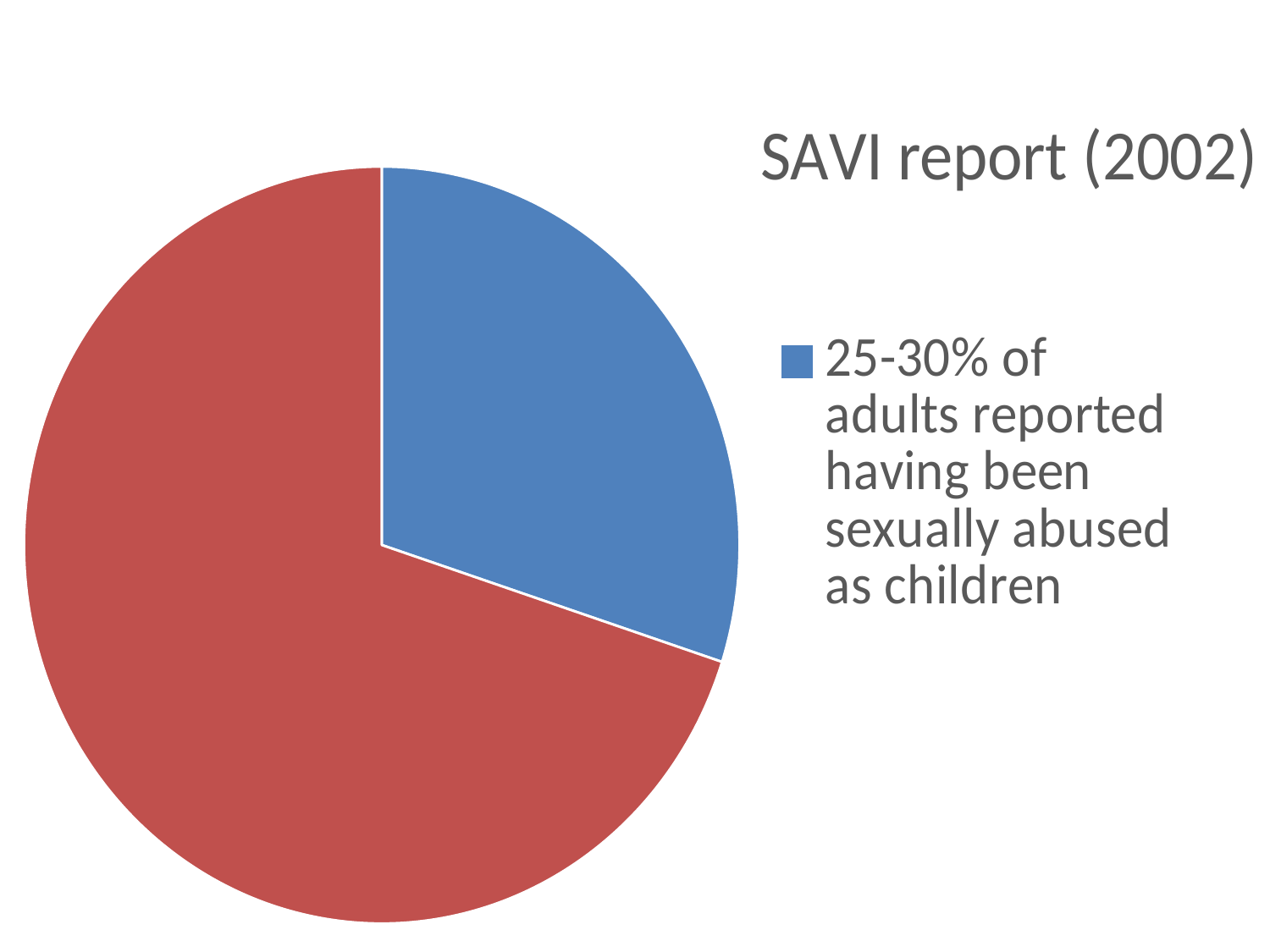
What colour is the slice labelled '25-30% of adults reported having been sexually abused as children' in the legend? blue Which slice is larger, the red slice or the blue slice? the red slice What kind of chart is shown on the slide? pie chart How many entries does the legend list? 1 How many slices does the pie chart have? 2 Which colour is the smallest slice of the pie? blue What is the title of the chart? SAVI report (2002) Which colour is the largest slice of the pie? red